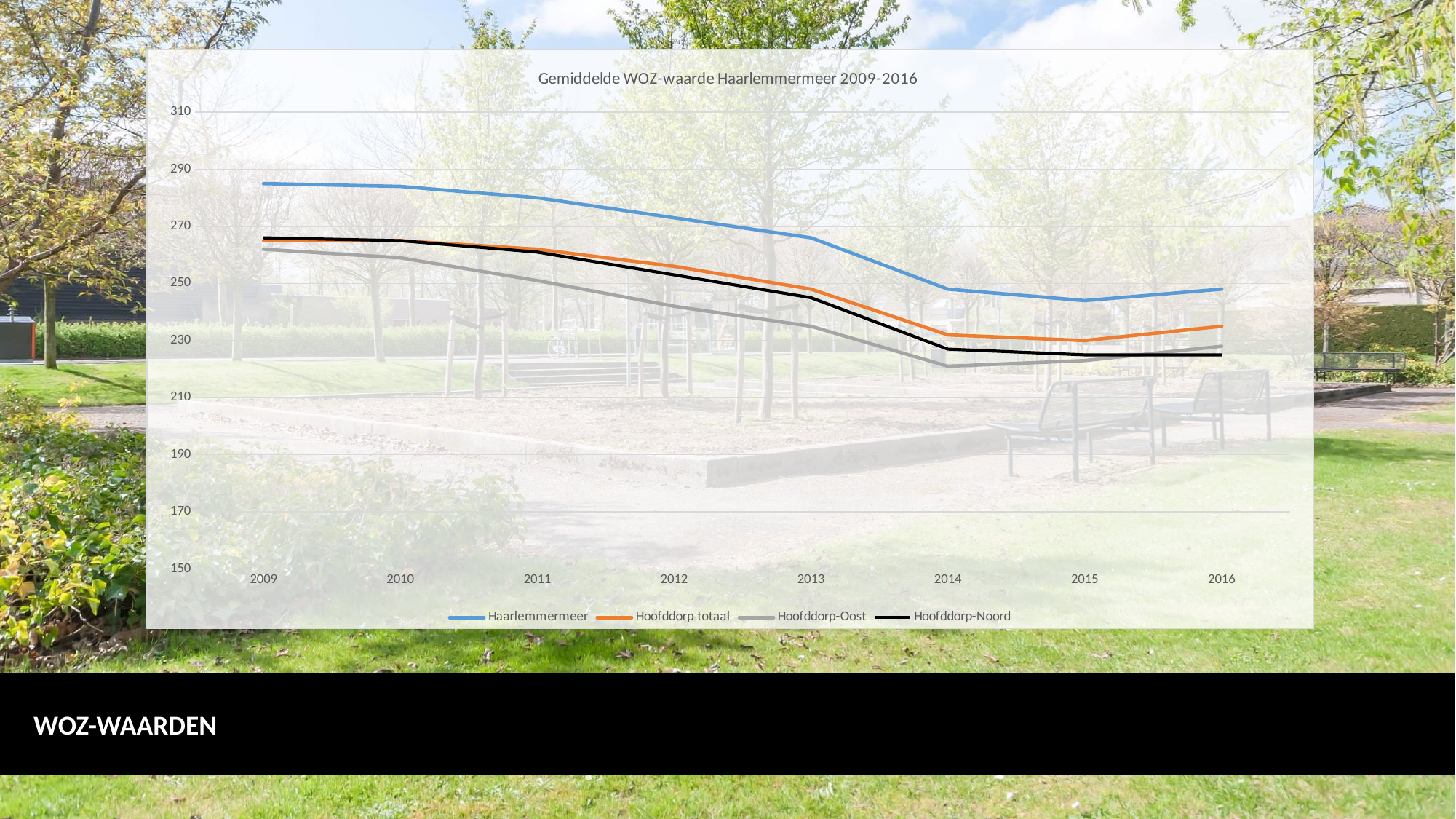
Does the Haarlemmermeer line rise or fall from 2009 to 2014? fall Is the value for Hoofddorp-Oost in 2014 greater or less than 230? less How many series does the legend list? 4 In 2016, which is higher: Hoofddorp totaal or Hoofddorp-Noord? Hoofddorp totaal Which series is drawn in orange? Hoofddorp totaal Which series has the highest values across all years? Haarlemmermeer What is the title of the chart? Gemiddelde WOZ-waarde Haarlemmermeer 2009-2016 Which series has the lowest value in 2014? Hoofddorp-Oost Is the value for Hoofddorp totaal in 2009 greater or less than 250? greater What kind of chart is shown on the slide? Line chart Is the value for Haarlemmermeer in 2009 greater or less than 270? greater How many years are plotted along the x axis? 8